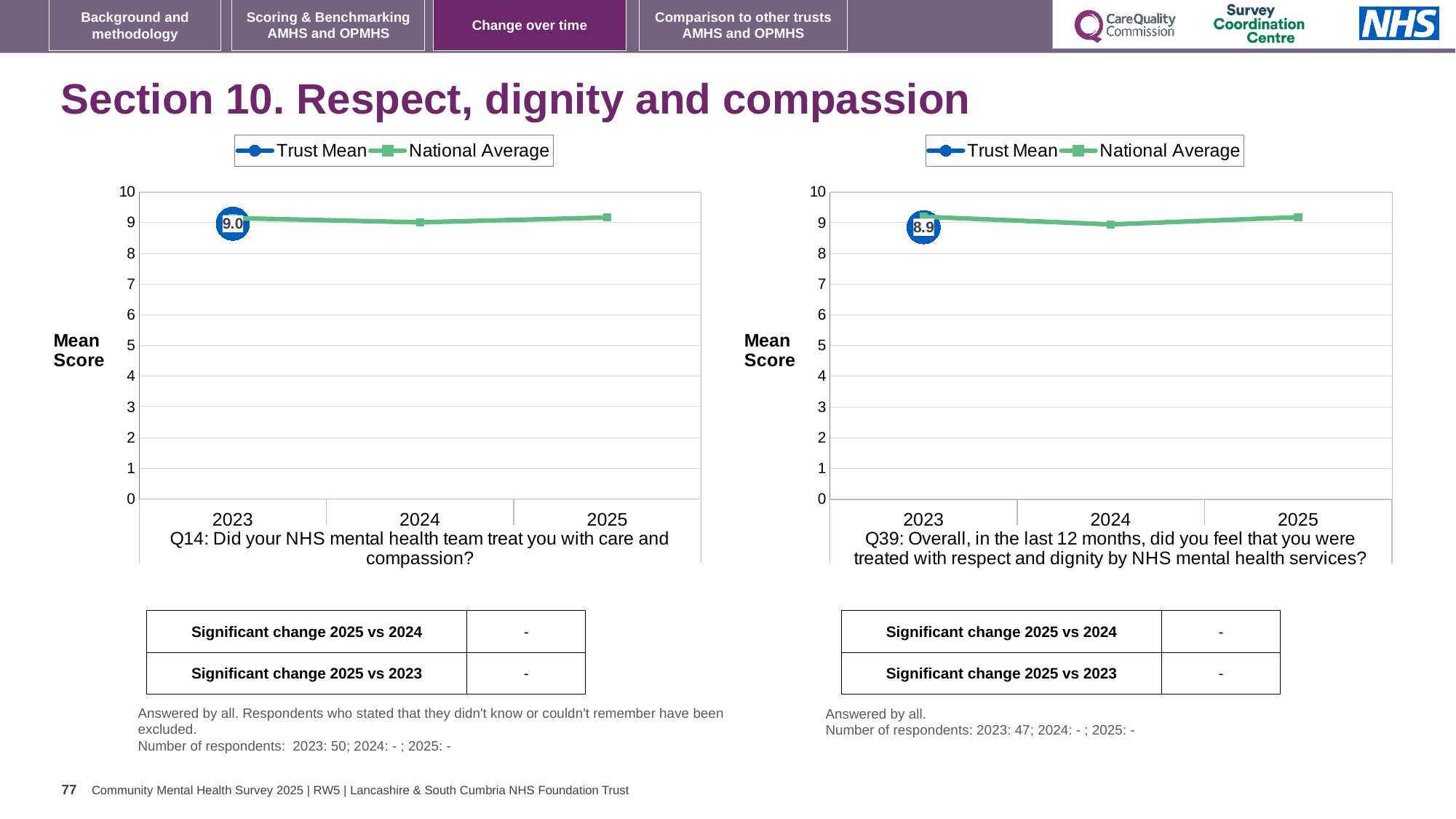
How many years are shown on the x axis of the right chart (Q39)? 3 How many series does the legend of the left chart (Q14) list? 2 What kind of chart is the left chart (Q14)? line chart In the left chart (Q14), what is the Trust Mean value for 2023? 9.0 In the left chart (Q14), is the National Average value for 2025 greater or less than 8? greater Which two series are listed in the legend of the right chart (Q39)? Trust Mean and National Average In the right chart (Q39), what is the Trust Mean value for 2023? 8.9 What is the y-axis title of the left chart (Q14)? Mean Score In the right chart (Q39), is the National Average value for 2024 greater or less than 8? greater What is the maximum value shown on the y axis of the right chart (Q39)? 10 What kind of chart is the right chart (Q39)? line chart In the right chart (Q39), is the Trust Mean value for 2023 greater or less than 5? greater